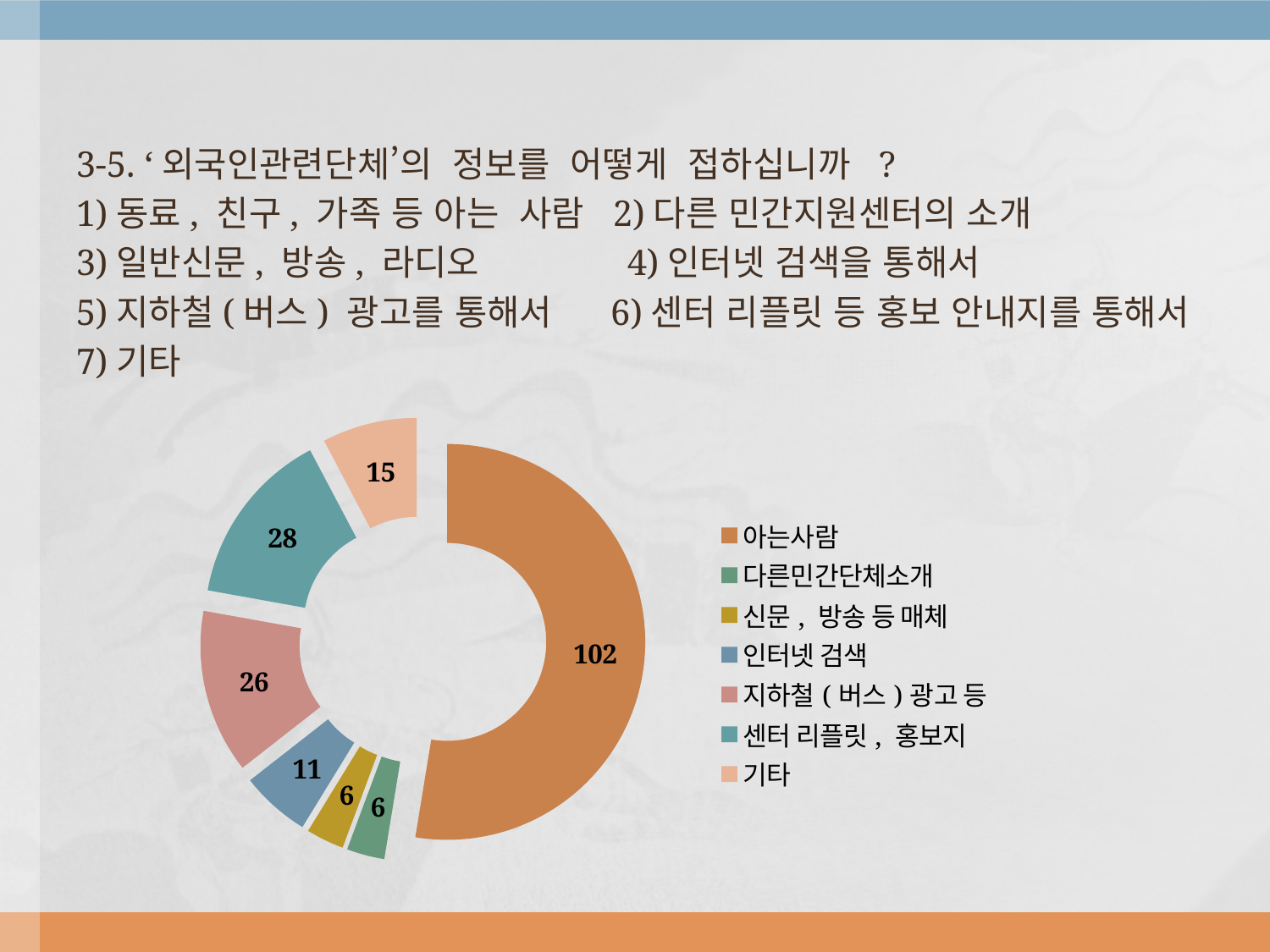
What kind of chart is shown on the slide? Doughnut (pie) chart Which is larger, the value for 센터 리플릿, 홍보지 or the value for 지하철 (버스) 광고 등? 센터 리플릿, 홍보지 What is the value for 기타 in the chart? 15 What is the difference between the values for 지하철 (버스) 광고 등 and 인터넷 검색? 15 What is the difference between the values for 아는사람 and 센터 리플릿, 홍보지? 74 What colour is the 아는사람 segment in the chart? Orange What is the value for 지하철 (버스) 광고 등 in the chart? 26 What is the value for 아는사람 in the chart? 102 Which category has the highest value in the chart? 아는사람 What is the value for 센터 리플릿, 홍보지 in the chart? 28 What is the value for 인터넷 검색 in the chart? 11 How many categories are shown in the chart? 7